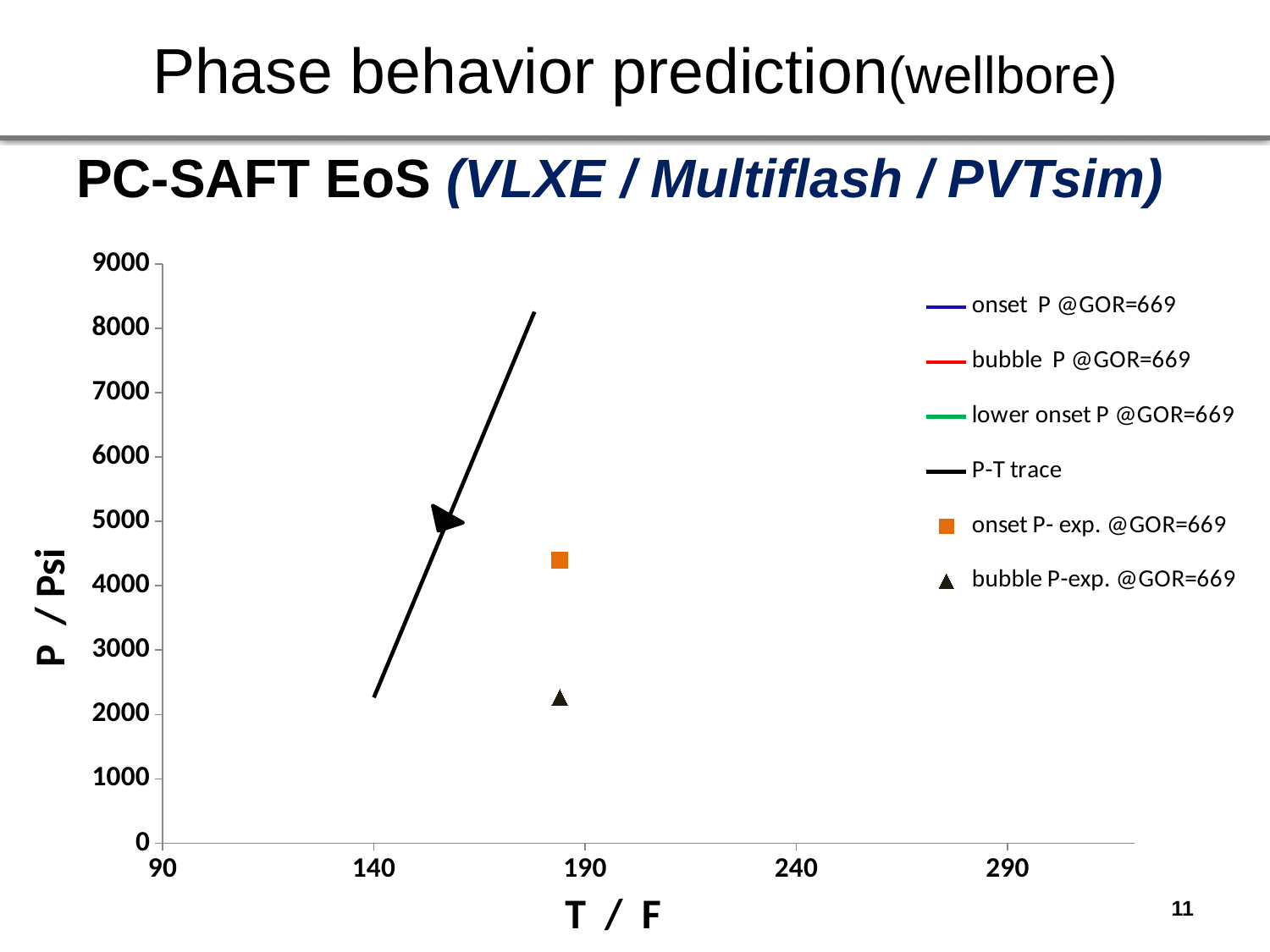
Is the temperature of the onset P-exp. @GOR=669 point greater or less than 140? greater What is the title of the y axis? P / Psi What kind of chart is shown on the slide? Line and scatter chart Which experimental point has the higher pressure, onset P-exp. @GOR=669 or bubble P-exp. @GOR=669? onset P-exp. @GOR=669 Does the P-T trace line rise or fall as temperature increases along the x axis? rise Is the pressure value of the bubble P-exp. @GOR=669 point greater or less than 2000? greater What is the title of the x axis? T / F Is the pressure value of the bubble P-exp. @GOR=669 point greater or less than 3000? less How many series does the legend list? 6